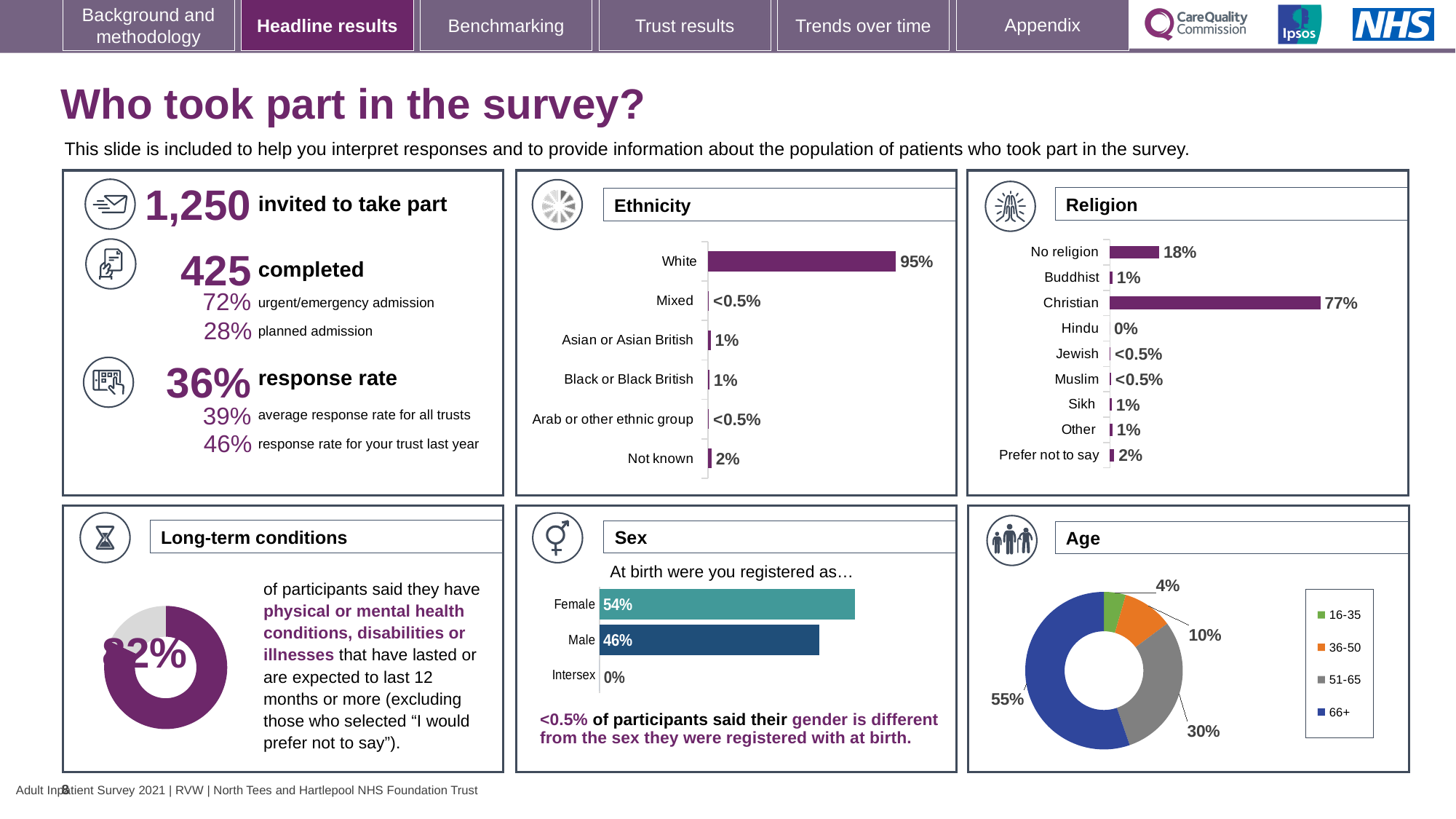
In the Ethnicity chart, what is the value for Not known? 2% How many categories are shown in the Religion chart? 9 How many categories are shown in the Ethnicity chart? 6 In the Sex chart, which is larger, Female or Male? Female In the Religion chart, what is the value for Hindu? 0% In the Religion chart, what percentage of participants were Christian? 77% In the Ethnicity chart, what percentage of participants were White? 95% In the Religion chart, what is the difference between the Christian and No religion values? 59% In the Ethnicity chart, which category has the highest value? White In the Age chart, what share of participants were aged 66+? 55% In the Sex chart, what percentage of participants were registered as Female at birth? 54% What kind of chart is the Age chart? Donut (pie) chart